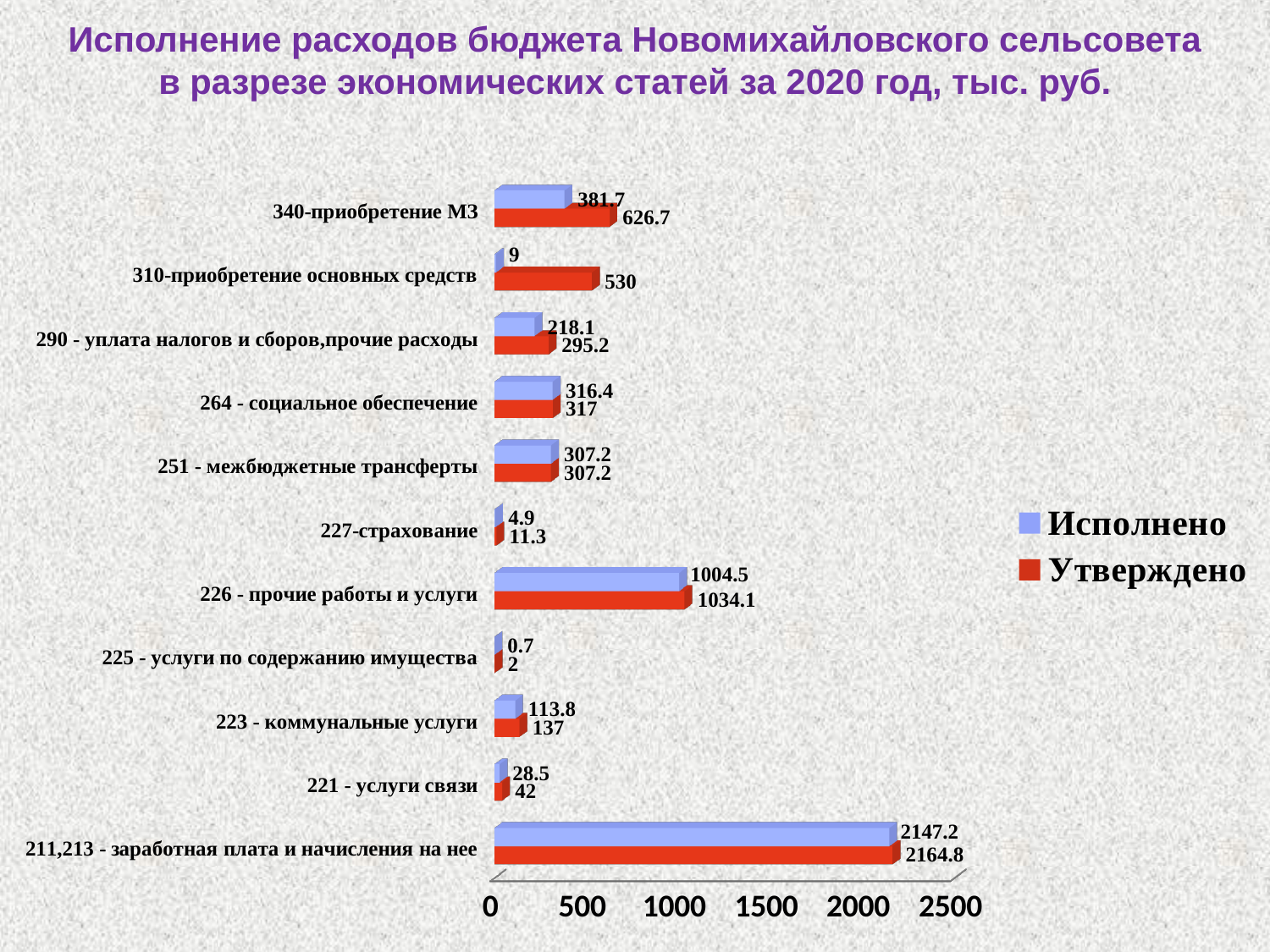
Which category has the highest Утверждено value? 211,213 - заработная плата и начисления на нее Which is larger for 223 - коммунальные услуги: the Исполнено value or the Утверждено value? Утверждено How many series does the legend list? 2 What is the Утверждено value for 211,213 - заработная плата и начисления на нее? 2164.8 What is the difference between the Утверждено and Исполнено values for 310-приобретение основных средств? 521 What is the Утверждено value for 310-приобретение основных средств? 530 How many categories are shown on the chart? 11 What is the Исполнено value for 226 - прочие работы и услуги? 1004.5 What is the Исполнено value for 340-приобретение МЗ? 381.7 What kind of chart is shown on the slide? Bar chart Which series is shown in red in the legend? Утверждено Which category has the lowest Исполнено value? 225 - услуги по содержанию имущества